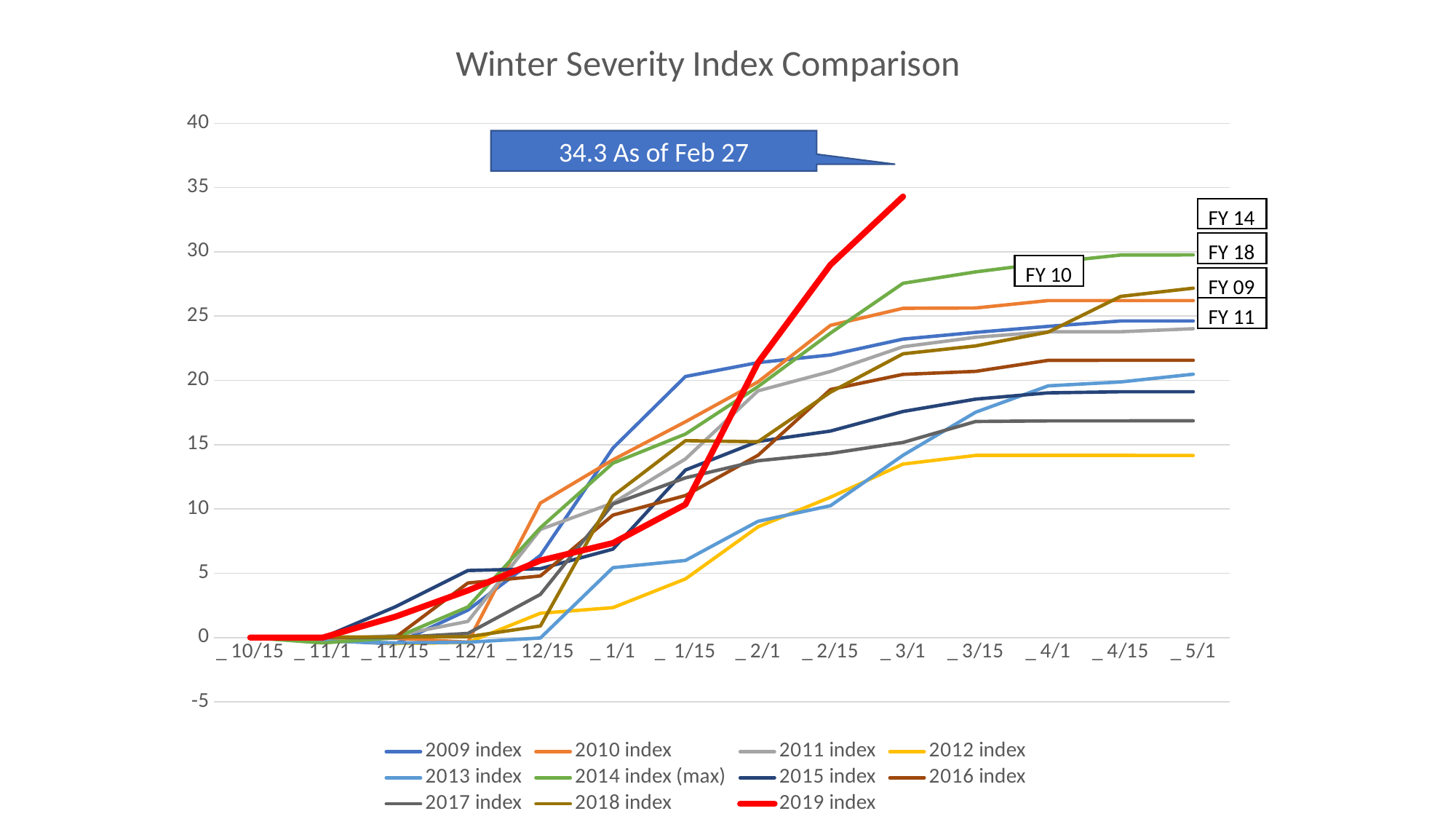
Does the 2019 index rise or fall from 10/15 to 3/1? rise At 5/1, which is larger: the 2010 index or the 2015 index? 2010 index Which series is drawn as the thick red line? 2019 index Is the value of the 2016 index at 5/1 greater or less than 20? greater Which series has the lowest value at 5/1? 2012 index What value does the callout give for the 2019 index as of Feb 27? 34.3 How many series does the legend list? 11 How many date categories are shown along the x axis? 14 What type of chart is shown on the slide? line chart Which series has the highest value at 5/1? 2014 index (max) What is the title of the chart? Winter Severity Index Comparison Is the value of the 2012 index at 5/1 greater or less than 15? less